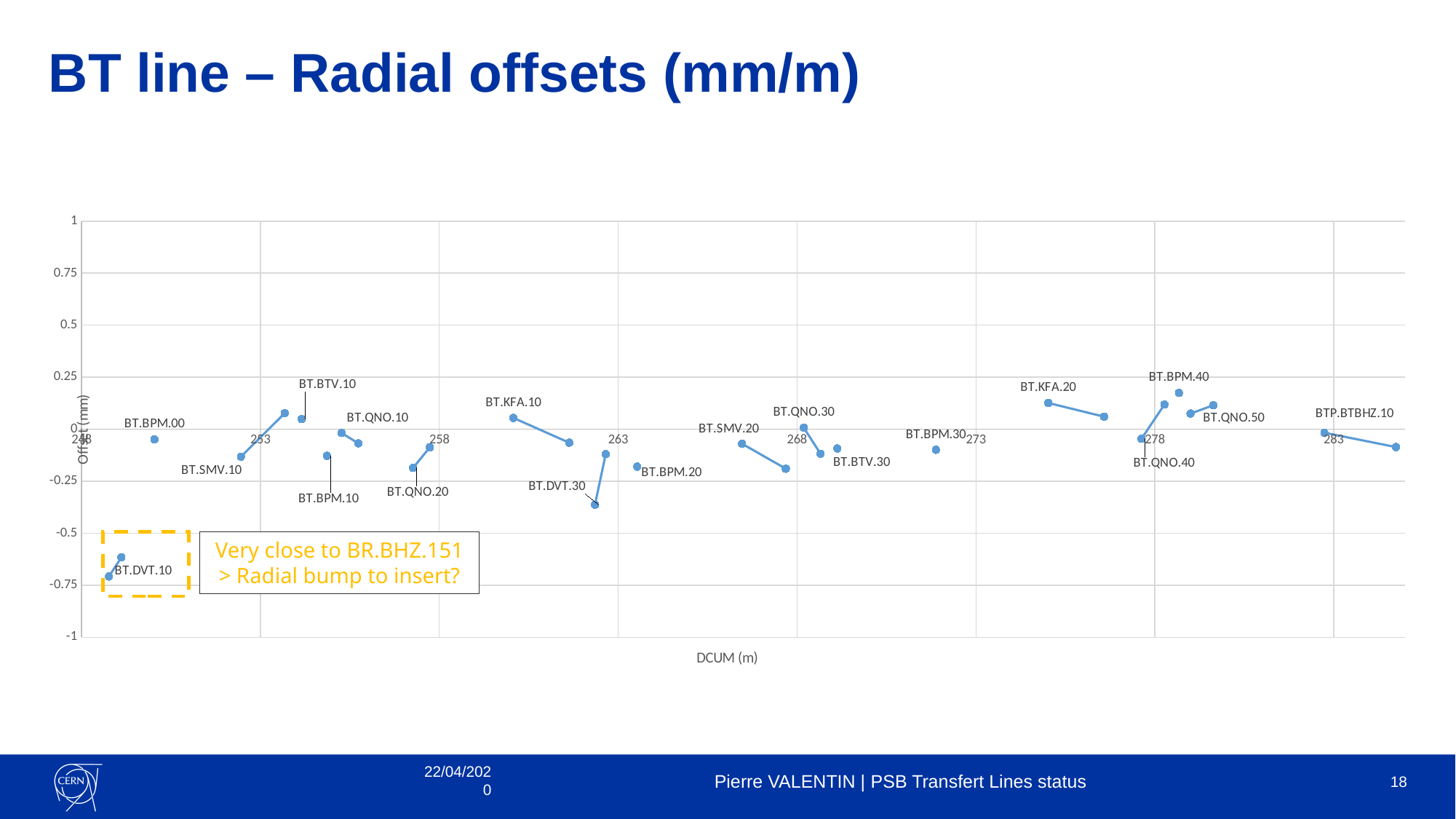
Is the offset for BT.BPM.40 greater or less than 0.25? less Which has the lower offset, BT.DVT.10 or BT.DVT.30? BT.DVT.10 What is the label of the x axis? DCUM (m) Is the offset for BT.SMV.20 greater or less than 0? less Which element is highlighted by the dashed box with the note about BR.BHZ.151? BT.DVT.10 What kind of chart is shown on the slide? scatter chart Is the offset for BT.KFA.20 greater or less than 0? greater Which element has the lowest radial offset in the chart? BT.DVT.10 Which has the larger offset, BT.KFA.10 or BT.BPM.20? BT.KFA.10